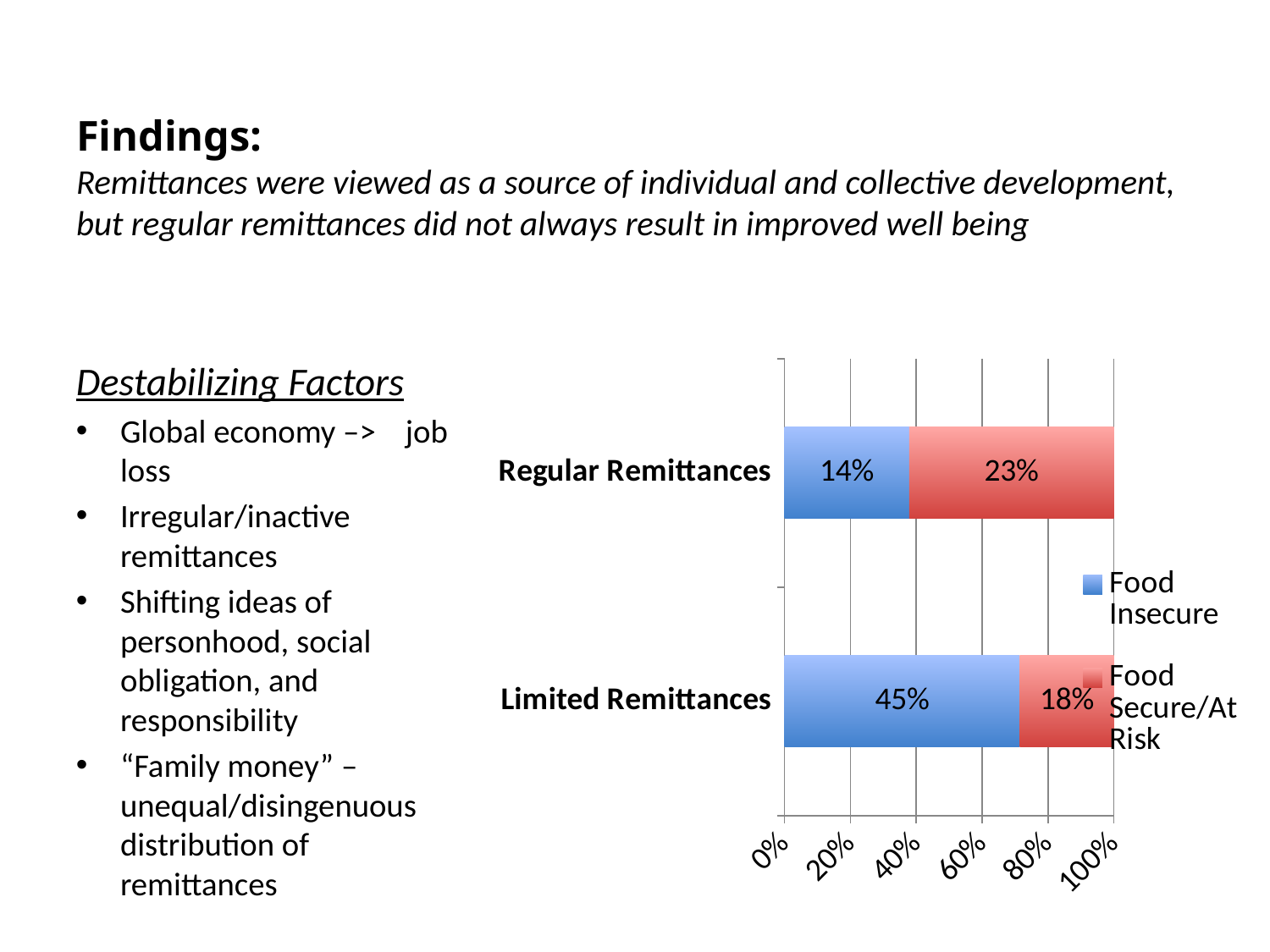
What kind of chart is shown on the slide? Stacked bar chart What is the Food Insecure value for Limited Remittances? 45% Which category has the higher Food Insecure value? Limited Remittances How many series does the legend list? 2 What is the Food Secure/At Risk value for Limited Remittances? 18% What is the difference between the Food Insecure values for Limited Remittances and Regular Remittances? 31 percentage points What is the Food Insecure value for Regular Remittances? 14% How many categories are shown on the chart? 2 For Regular Remittances, which is larger: the Food Insecure value or the Food Secure/At Risk value? Food Secure/At Risk Which category has the lower Food Secure/At Risk value? Limited Remittances What colour represents the Food Insecure series? Blue What is the Food Secure/At Risk value for Regular Remittances? 23%